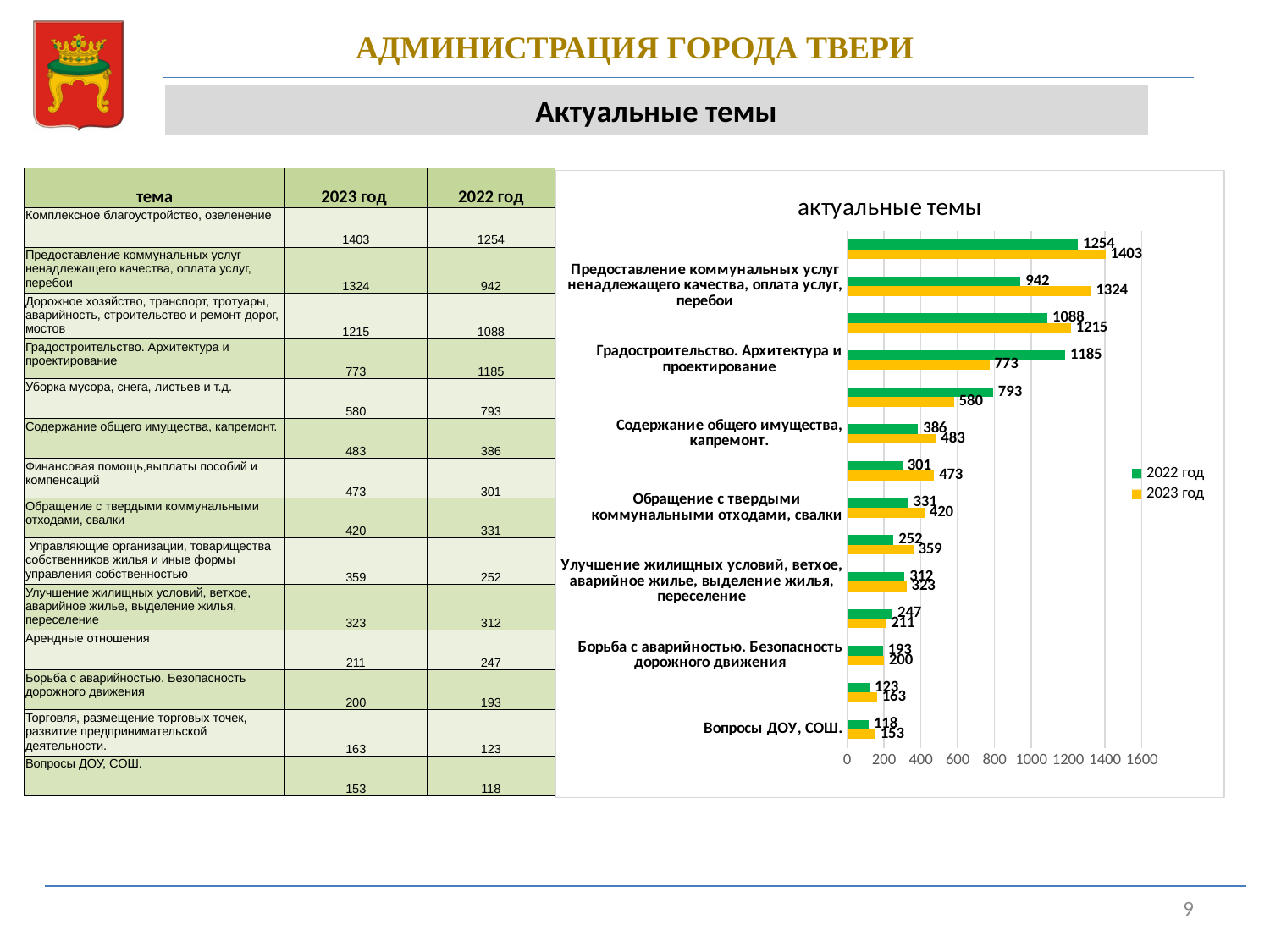
What is the 2023 год value for "Предоставление коммунальных услуг ненадлежащего качества, оплата услуг, перебои"? 1324 How many series does the chart legend list? 2 Which is larger for "Обращение с твердыми коммунальными отходами, свалки": the 2022 год value or the 2023 год value? 2023 год What is the 2022 год value for "Содержание общего имущества, капремонт."? 386 What kind of chart is shown on the slide? bar chart What is the chart's title? актуальные темы Which colour represents the 2022 год series in the chart? green What is the 2023 год value for "Вопросы ДОУ, СОШ."? 153 What is the difference between the 2023 год and 2022 год values for "Предоставление коммунальных услуг ненадлежащего качества, оплата услуг, перебои"? 382 Is the 2023 год value for "Борьба с аварийностью. Безопасность дорожного движения" greater or less than 400? less Which is larger for "Градостроительство. Архитектура и проектирование": the 2022 год value or the 2023 год value? 2022 год What is the 2022 год value for "Градостроительство. Архитектура и проектирование"? 1185